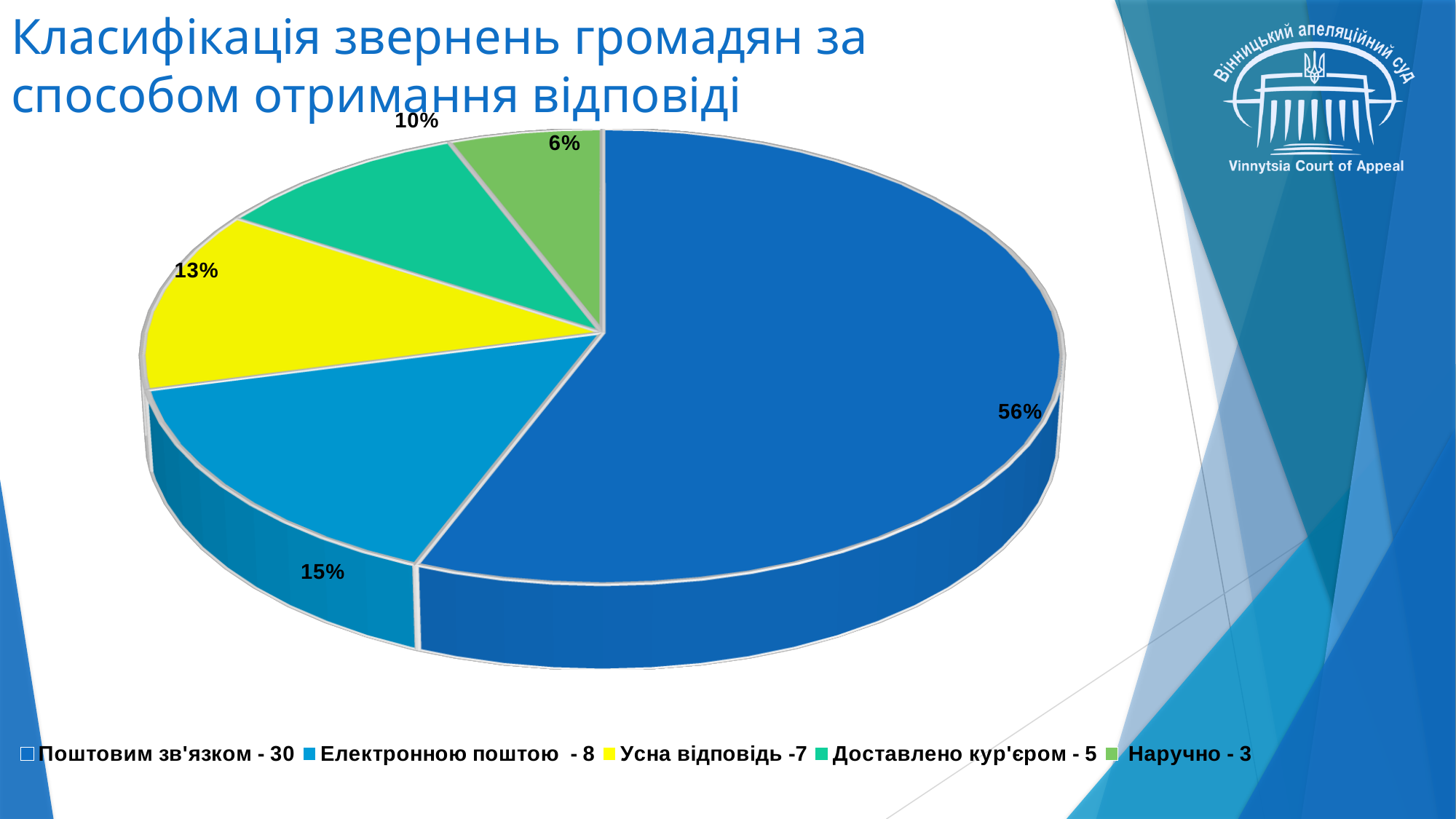
Which has a larger share: "Усна відповідь" or "Доставлено кур'єром"? Усна відповідь What percentage share is shown for the slice "Усна відповідь"? 13% How many slices does the pie chart have? 5 Which category has the largest share of the pie? Поштовим зв'язком What percentage share is shown for the slice "Електронною поштою"? 15% What is the title of the chart on the slide? Класифікація звернень громадян за способом отримання відповіді What percentage share is shown for the slice "Поштовим зв'язком"? 56% Which category has the smallest share of the pie? Наручно What is the difference in percentage points between the shares of "Поштовим зв'язком" and "Електронною поштою"? 41 What kind of chart is shown on the slide? pie chart